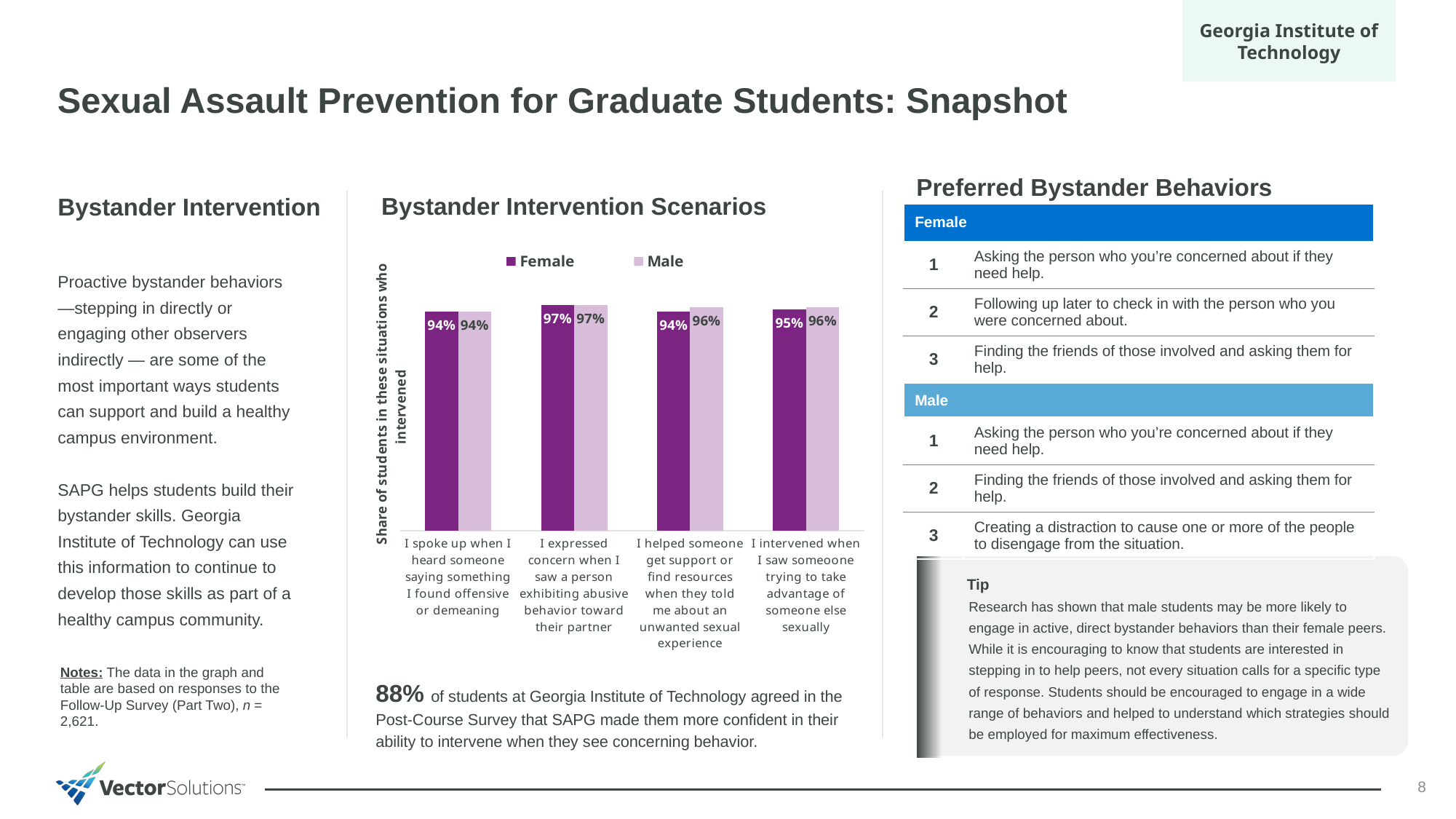
What is the Female value for 'I intervened when I saw someoone trying to take advantage of someone else sexually'? 95% What type of chart is shown under the title 'Bystander Intervention Scenarios'? Bar chart What is the difference between the Male and Female values for 'I helped someone get support or find resources when they told me about an unwanted sexual experience'? 2% What is the Male value for 'I helped someone get support or find resources when they told me about an unwanted sexual experience'? 96% What is the Male value for 'I spoke up when I heard someone saying something I found offensive or demeaning'? 94% How many scenario categories are shown on the x axis of the Bystander Intervention Scenarios chart? 4 Which scenario has the highest Female value in the Bystander Intervention Scenarios chart? I expressed concern when I saw a person exhibiting abusive behavior toward their partner What is the y-axis label of the Bystander Intervention Scenarios chart? Share of students in these situations who intervened For 'I intervened when I saw someoone trying to take advantage of someone else sexually', which is larger, the Female or the Male value? Male What is the Female value for 'I expressed concern when I saw a person exhibiting abusive behavior toward their partner'? 97% How many series does the legend of the Bystander Intervention Scenarios chart list? 2 Which scenario has the lowest Male value in the Bystander Intervention Scenarios chart? I spoke up when I heard someone saying something I found offensive or demeaning